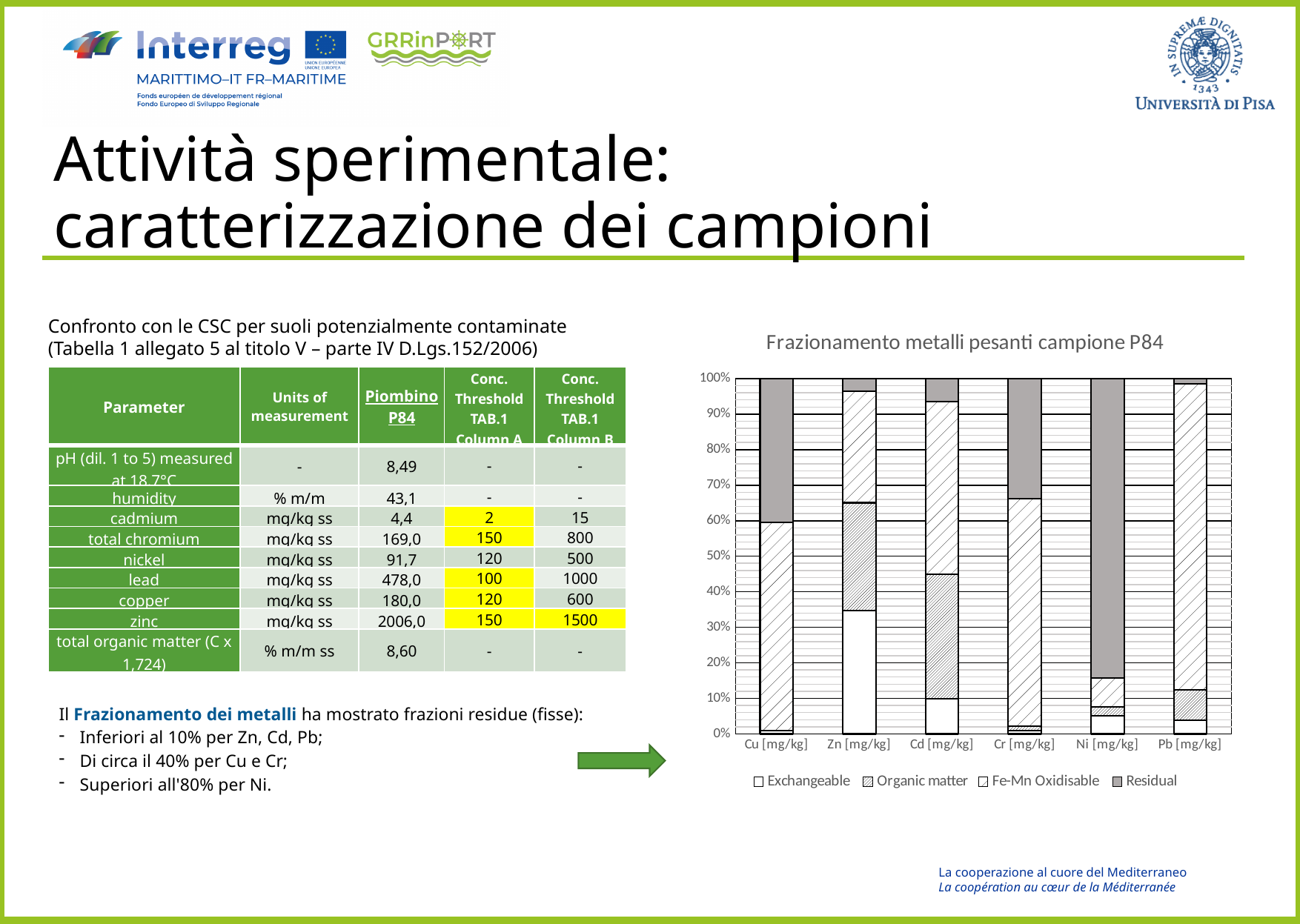
Which has the larger Exchangeable fraction, Zn [mg/kg] or Cd [mg/kg]? Zn [mg/kg] Which series are listed in the chart legend? Exchangeable, Organic matter, Fe-Mn Oxidisable, Residual How many metal categories are shown on the x axis of the chart? 6 What is the title of the chart? Frazionamento metalli pesanti campione P84 Is the Exchangeable fraction for Zn [mg/kg] greater or less than 30%? greater Which metal has the largest Residual fraction in the chart? Ni [mg/kg] Is the Exchangeable fraction for Cu [mg/kg] greater or less than 10%? less Which metal has the largest Exchangeable fraction in the chart? Zn [mg/kg] Is the Residual fraction for Ni [mg/kg] greater or less than 70%? greater What kind of chart is shown on the slide? Stacked bar chart Which has the larger Residual fraction, Ni [mg/kg] or Pb [mg/kg]? Ni [mg/kg] How many series does the chart legend list? 4